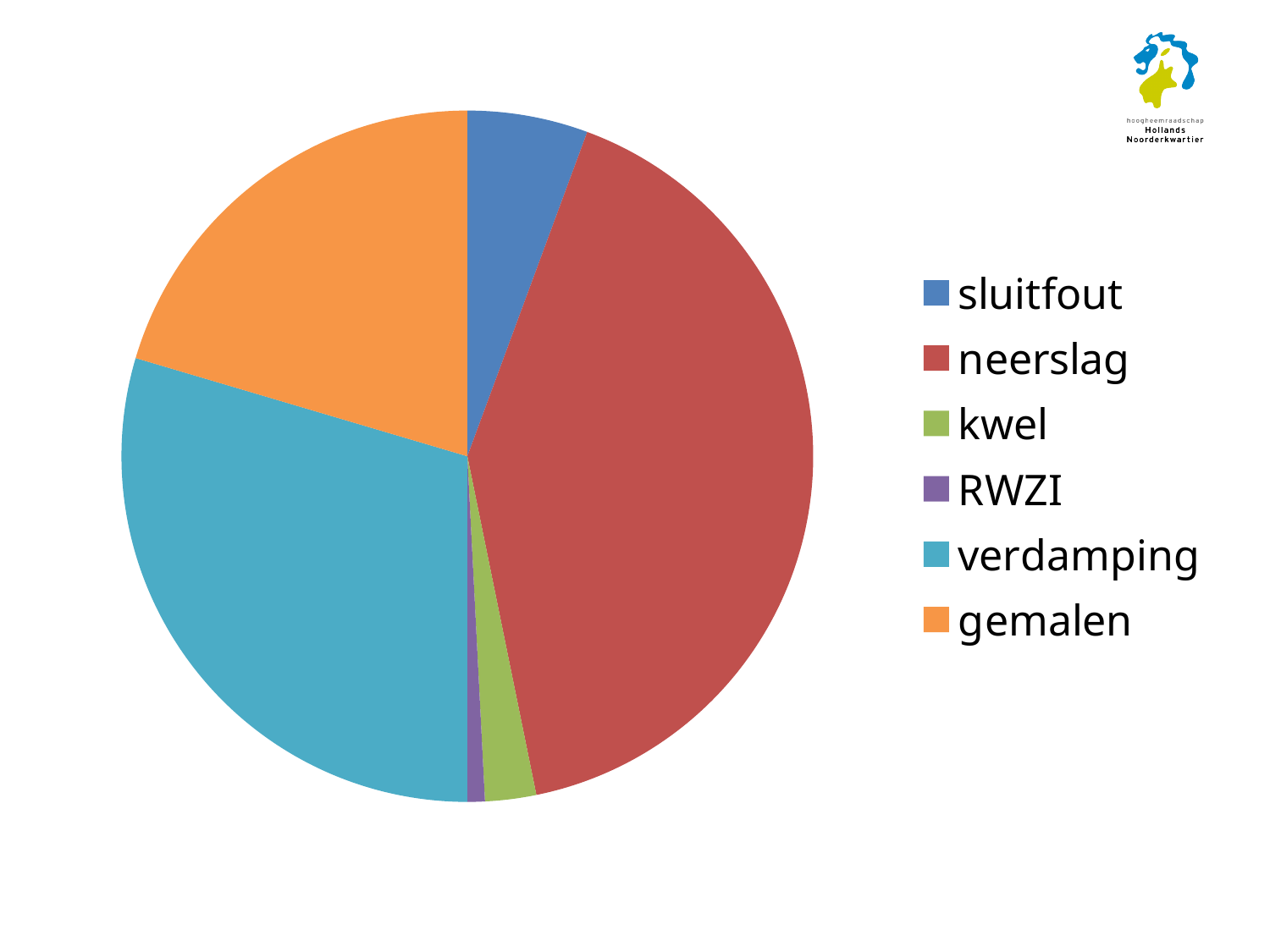
Which slice is larger, sluitfout or kwel? sluitfout Which slice is larger, verdamping or gemalen? verdamping Which legend entry is shown in orange? gemalen What kind of chart is shown on the slide? pie chart Which slice is larger, gemalen or sluitfout? gemalen Which category has the smallest slice of the pie? RWZI How many entries does the legend list? 6 What colour is the neerslag slice in the pie chart? red Which category has the largest slice of the pie? neerslag How many slices does the pie chart have? 6